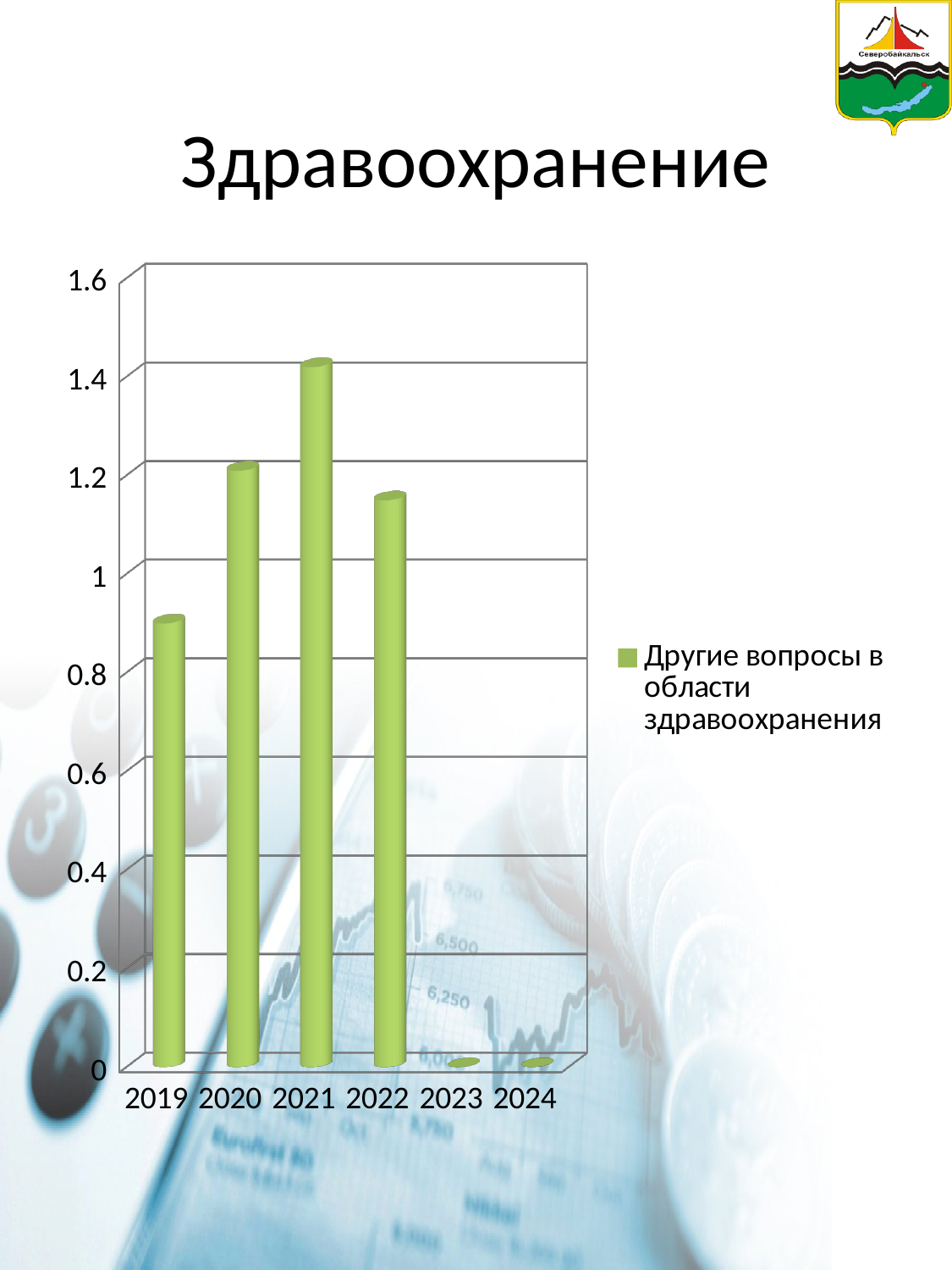
Is the value for 2023 greater or less than 0.2? less Is the value for 2021 greater or less than 1.2? greater Which year has the larger value, 2021 or 2022? 2021 What is the title of the slide containing the chart? Здравоохранение How many series does the chart legend list? 1 Do the values rise or fall from 2019 to 2021? rise Is the value for 2019 greater or less than 1? less Which year has the larger value, 2019 or 2020? 2020 How many years are shown on the x axis of the chart? 6 Which year has the highest value in the chart? 2021 What kind of chart is shown on the slide? Bar chart